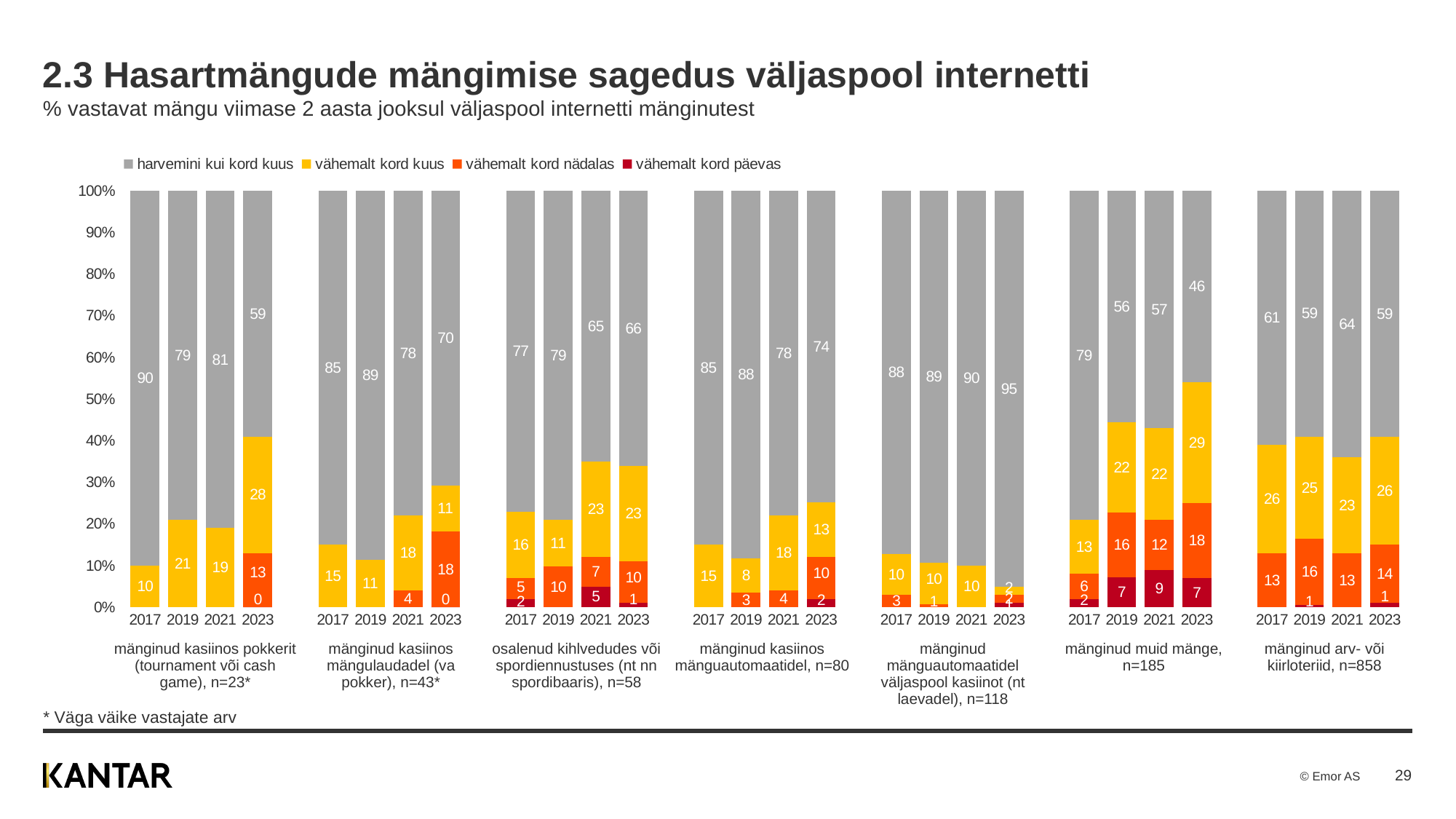
For "mänginud mänguautomaatidel väljaspool kasiinot", does the "harvemini kui kord kuus" value rise or fall from 2017 to 2023? rise How many series does the legend list? 4 What is the value of "vähemalt kord nädalas" for "mänginud arv- või kiirloteriid" in 2019? 16 What is the value of "vähemalt kord päevas" for "mänginud muid mänge" in 2021? 9 In 2023, which group has the lowest value for "harvemini kui kord kuus"? mänginud muid mänge How many gambling activity groups are shown on the chart? 7 In 2023, which group has the highest value for "harvemini kui kord kuus"? mänginud mänguautomaatidel väljaspool kasiinot (nt laevadel) What kind of chart is shown on the slide? stacked bar chart For "mänginud kasiinos pokkerit", how much higher is the "vähemalt kord kuus" value in 2023 than in 2017? 18 In 2023, which has the larger "vähemalt kord nädalas" value: "mänginud muid mänge" or "mänginud arv- või kiirloteriid"? mänginud muid mänge What is the value of "vähemalt kord kuus" for "mänginud muid mänge" in 2023? 29 What is the value of "harvemini kui kord kuus" for "mänginud kasiinos pokkerit" in 2017? 90